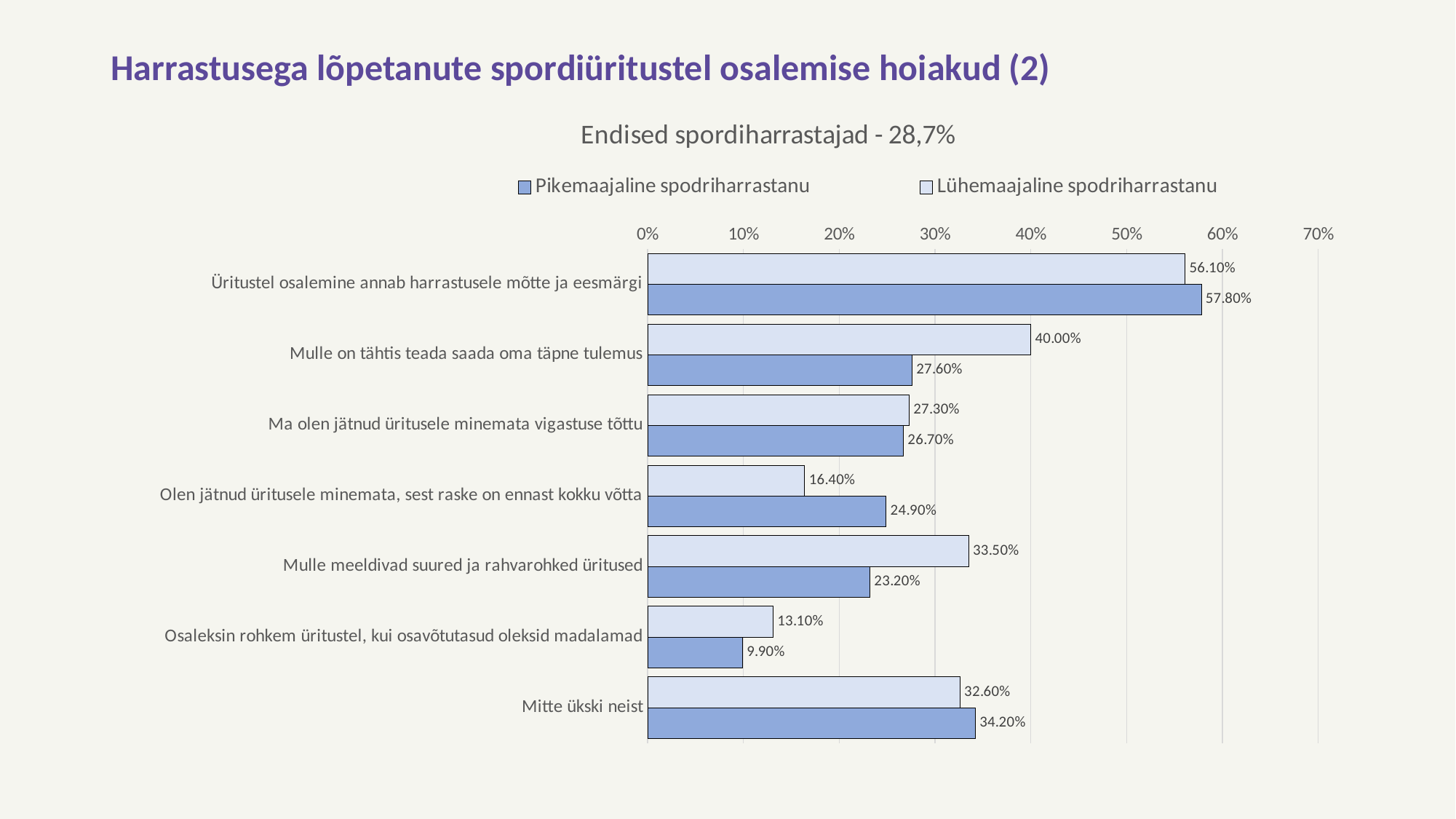
What is the value for Pikemaajaline spodriharrastanu for "Mulle on tähtis teada saada oma täpne tulemus"? 27.60% Which category has the lowest value for Pikemaajaline spodriharrastanu? Osaleksin rohkem üritustel, kui osavõtutasud oleksid madalamad Which category has the highest value for Lühemaajaline spodriharrastanu? Üritustel osalemine annab harrastusele mõtte ja eesmärgi What is the value for Lühemaajaline spodriharrastanu for "Mulle meeldivad suured ja rahvarohked üritused"? 33.50% What is the value for Pikemaajaline spodriharrastanu for "Osaleksin rohkem üritustel, kui osavõtutasud oleksid madalamad"? 9.90% How many series does the legend list? 2 Is the Pikemaajaline spodriharrastanu value for "Mitte ükski neist" greater or less than 30%? greater How many categories are shown on the chart? 7 What kind of chart is shown on the slide? Bar chart For "Olen jätnud üritusele minemata, sest raske on ennast kokku võtta", which series has the larger value? Pikemaajaline spodriharrastanu What is the difference between the Lühemaajaline and Pikemaajaline values for "Mulle on tähtis teada saada oma täpne tulemus"? 12.40% What is the title of the chart? Endised spordiharrastajad - 28,7%